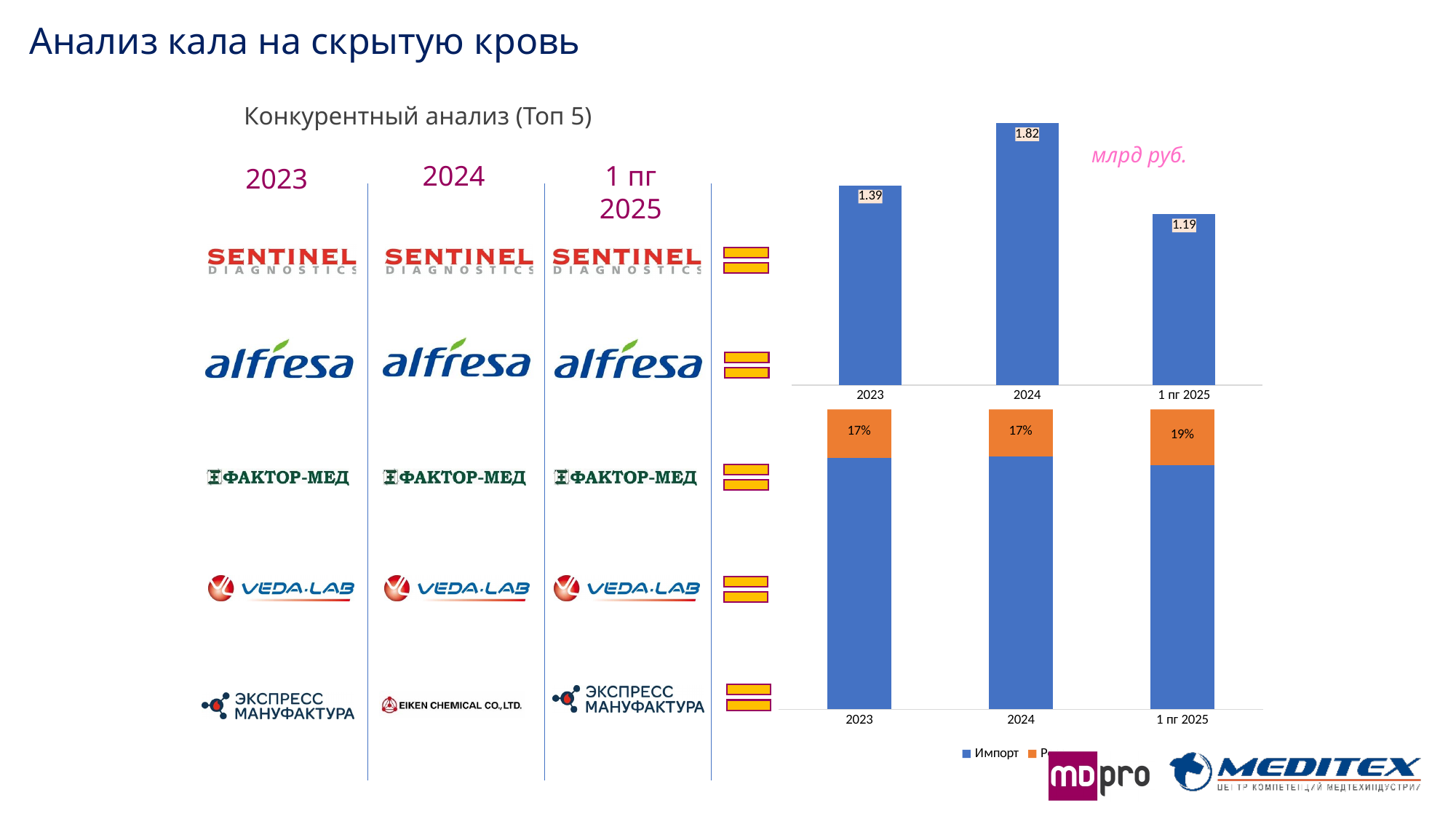
In the top bar chart, what is the difference between the 2024 and 2023 values? 0.43 In the top bar chart, what is the value for 1 пг 2025? 1.19 In the top bar chart, which period has the highest value? 2024 In the top bar chart, what is the value for 2023? 1.39 In the top bar chart, what unit is shown next to the bars? млрд руб. How many bars are in the top bar chart? 3 In the top bar chart, what is the value for 2024? 1.82 In the bottom stacked bar chart, what is the orange segment's share for 2023? 17% In the top bar chart, which is larger: the value for 2023 or for 1 пг 2025? 2023 What type of chart is the bottom chart? Stacked bar chart In the bottom stacked bar chart, what is the orange segment's share for 1 пг 2025? 19% In the top bar chart, which period has the lowest value? 1 пг 2025